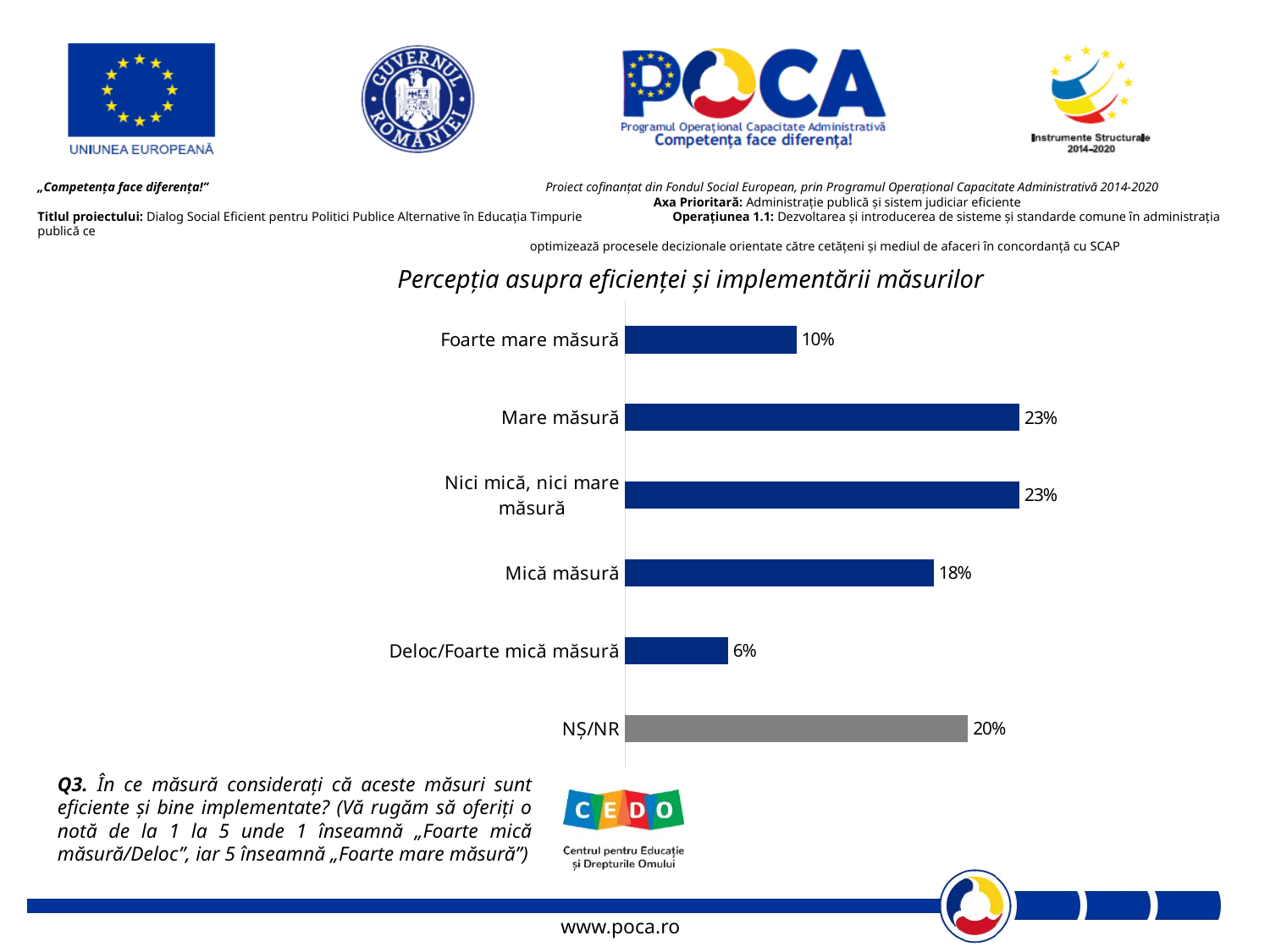
What is the difference between the values for "NȘ/NR" and "Mică măsură"? 2% What is the title of the chart? Percepția asupra eficienței și implementării măsurilor What is the value for "Mică măsură"? 18% What is the difference between the values for "Mare măsură" and "Foarte mare măsură"? 13% Which is larger, the value for "Mică măsură" or the value for "Foarte mare măsură"? Mică măsură What is the value for "NȘ/NR"? 20% What is the value for "Foarte mare măsură"? 10% What is the value for "Deloc/Foarte mică măsură"? 6% What kind of chart is shown on the slide? Bar chart Which is larger, the value for "NȘ/NR" or the value for "Deloc/Foarte mică măsură"? NȘ/NR Which category has the lowest value? Deloc/Foarte mică măsură How many categories are shown in the chart? 6